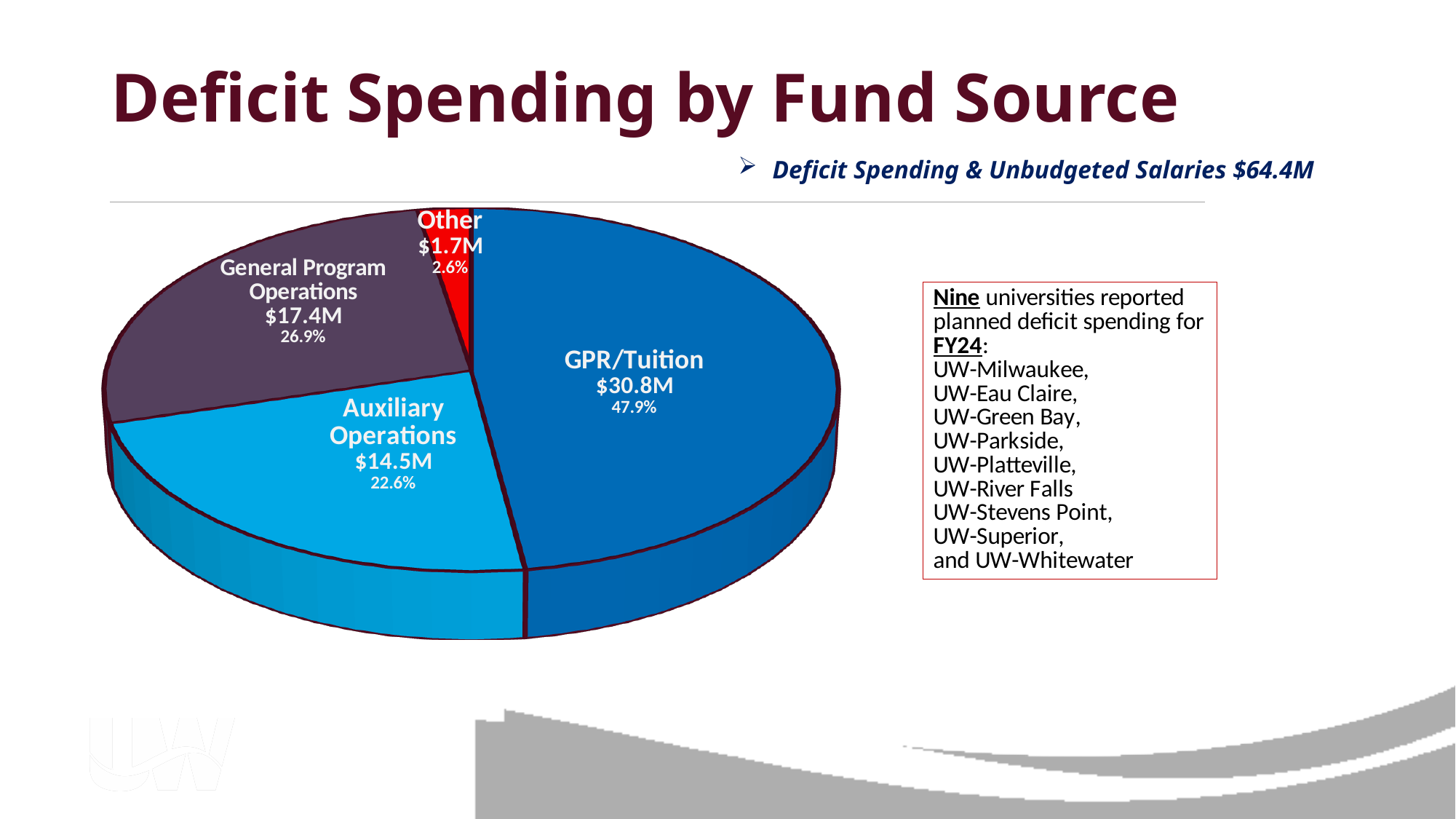
What is the difference in deficit spending between GPR/Tuition and General Program Operations? $13.4M What percentage share of the pie does Auxiliary Operations represent? 22.6% What is the deficit spending value for GPR/Tuition? $30.8M What kind of chart is shown on the slide? pie chart What is the deficit spending value for Auxiliary Operations? $14.5M Which fund source has the smallest share of deficit spending? Other What percentage share of the pie does General Program Operations represent? 26.9% Which is larger, the deficit spending for Auxiliary Operations or for General Program Operations? General Program Operations What is the deficit spending value for General Program Operations? $17.4M Which fund source has the largest share of deficit spending? GPR/Tuition What is the deficit spending value for Other? $1.7M How many fund source slices are shown in the pie chart? 4